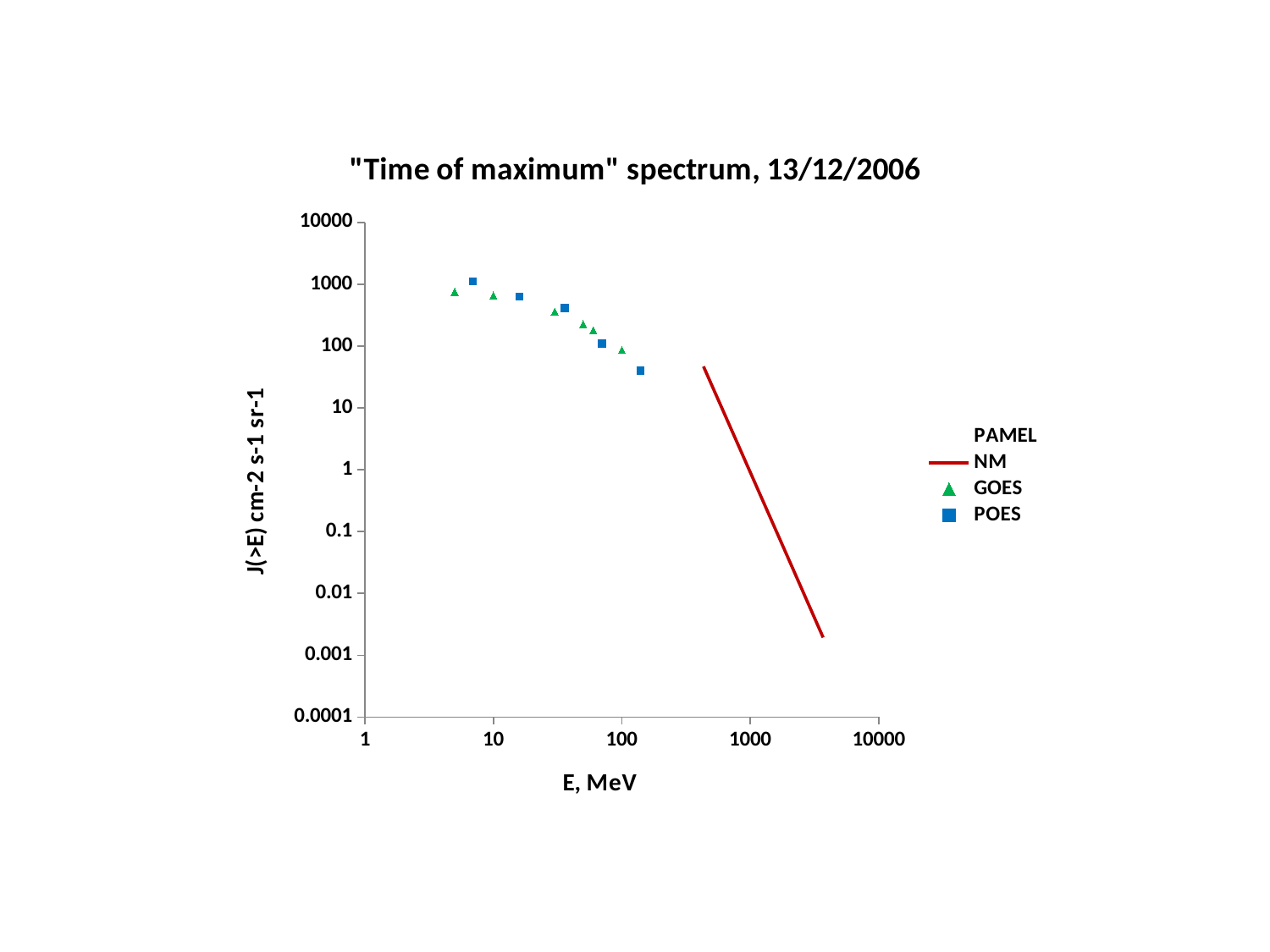
How many series does the legend list? 4 Is the GOES value at the lowest energy (around 5 MeV) greater or less than 100? greater Which series reaches the lowest values on the chart, NM or POES? NM Is the POES value at the highest energy (around 140 MeV) greater or less than 100? less Do the plotted values rise or fall as E increases along the x axis? fall Which series is drawn as a red line? NM How many POES data points are plotted? 5 What is the label of the x axis? E, MeV What is the title of the chart? "Time of maximum" spectrum, 13/12/2006 Is the highest value of the NM line greater or less than 10? greater What kind of chart is shown on the slide? scatter chart